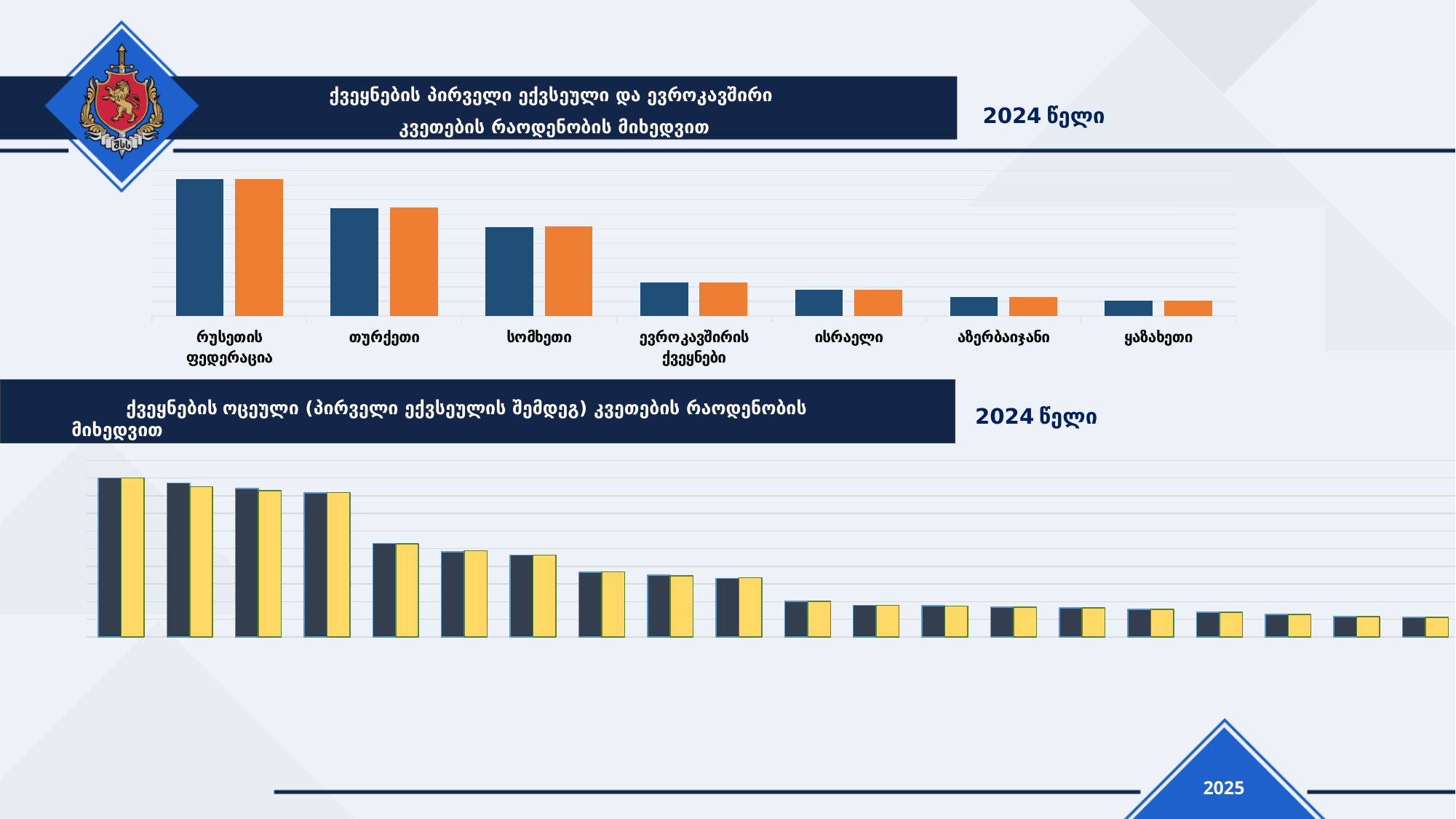
In the top chart, how many categories are shown on the x axis? 7 What kind of chart is the bottom chart on the slide? bar chart In the top chart, which category has the lowest bars? ყაზახეთი In the top chart, which has the higher values, ევროკავშირის ქვეყნები or ყაზახეთი? ევროკავშირის ქვეყნები In the top chart, which has the higher values, ისრაელი or აზერბაიჯანი? ისრაელი What kind of chart is the top chart on the slide? bar chart In the bottom chart, how many groups of bars are plotted? 20 In the top chart, which category has the highest bars? რუსეთის ფედერაცია In the top chart, do the values rise or fall from left to right along the x axis? fall In the bottom chart, do the values rise or fall from left to right along the x axis? fall Which year is shown next to the title of the top chart? 2024 წელი In the top chart, which has the higher values, თურქეთი or სომხეთი? თურქეთი